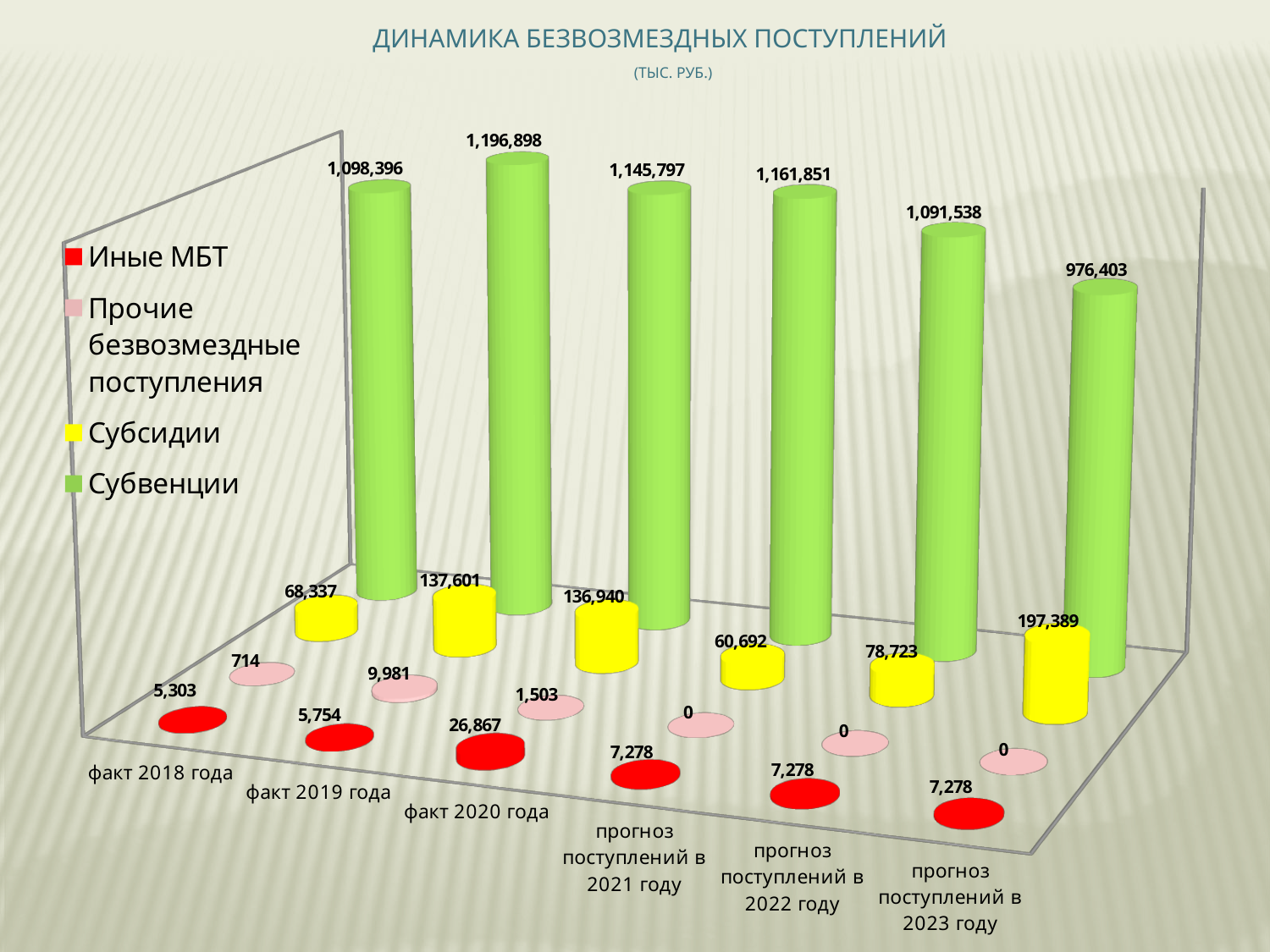
What is the value of Прочие безвозмездные поступления for прогноз поступлений в 2022 году? 0 In which category is Субсидии the highest? прогноз поступлений в 2023 году How many categories are shown on the x axis? 6 How many series does the legend list? 4 What is the difference between Субвенции for факт 2019 года and факт 2018 года? 98,502 What is the value of Субвенции for факт 2019 года? 1,196,898 What is the value of Иные МБТ for факт 2020 года? 26,867 What is the value of Прочие безвозмездные поступления for факт 2019 года? 9,981 Which is larger: Субсидии for факт 2019 года or for факт 2020 года? факт 2019 года In which category is Субвенции the lowest? прогноз поступлений в 2023 году What is the value of Субсидии for прогноз поступлений в 2023 году? 197,389 What kind of chart is shown on the slide? bar chart